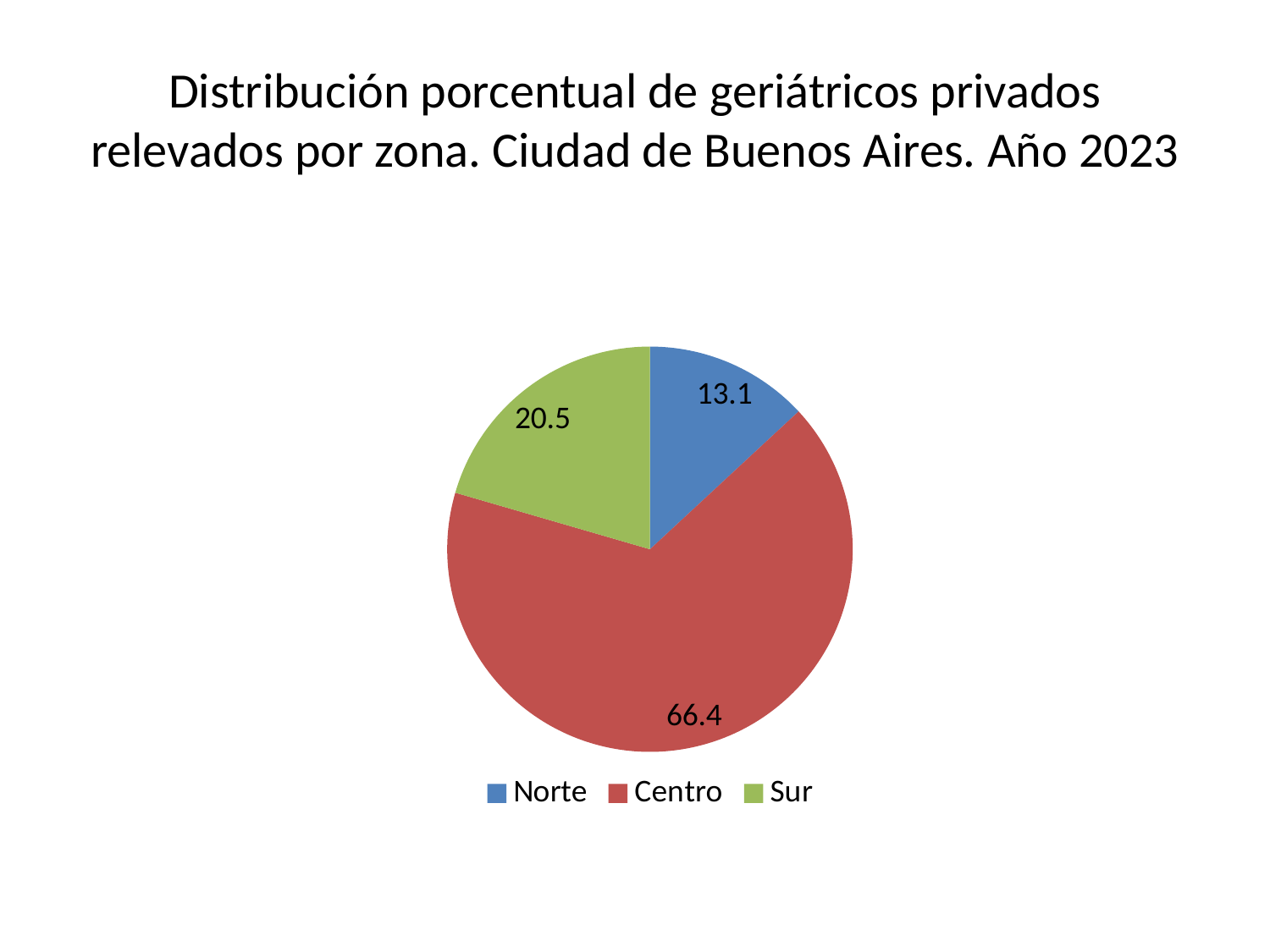
What is the difference between the values for Sur and Norte? 7.4 Which zone has the largest slice? Centro What is the value for Centro? 66.4 What year does the chart title refer to? 2023 Which colour represents Sur in the chart? green What is the difference between the values for Centro and Sur? 45.9 Which zone has the smallest slice? Norte How many slices does the pie chart have? 3 What is the value for Sur? 20.5 What kind of chart is shown on the slide? pie chart Which is larger, the value for Sur or the value for Norte? Sur What is the value for Norte? 13.1